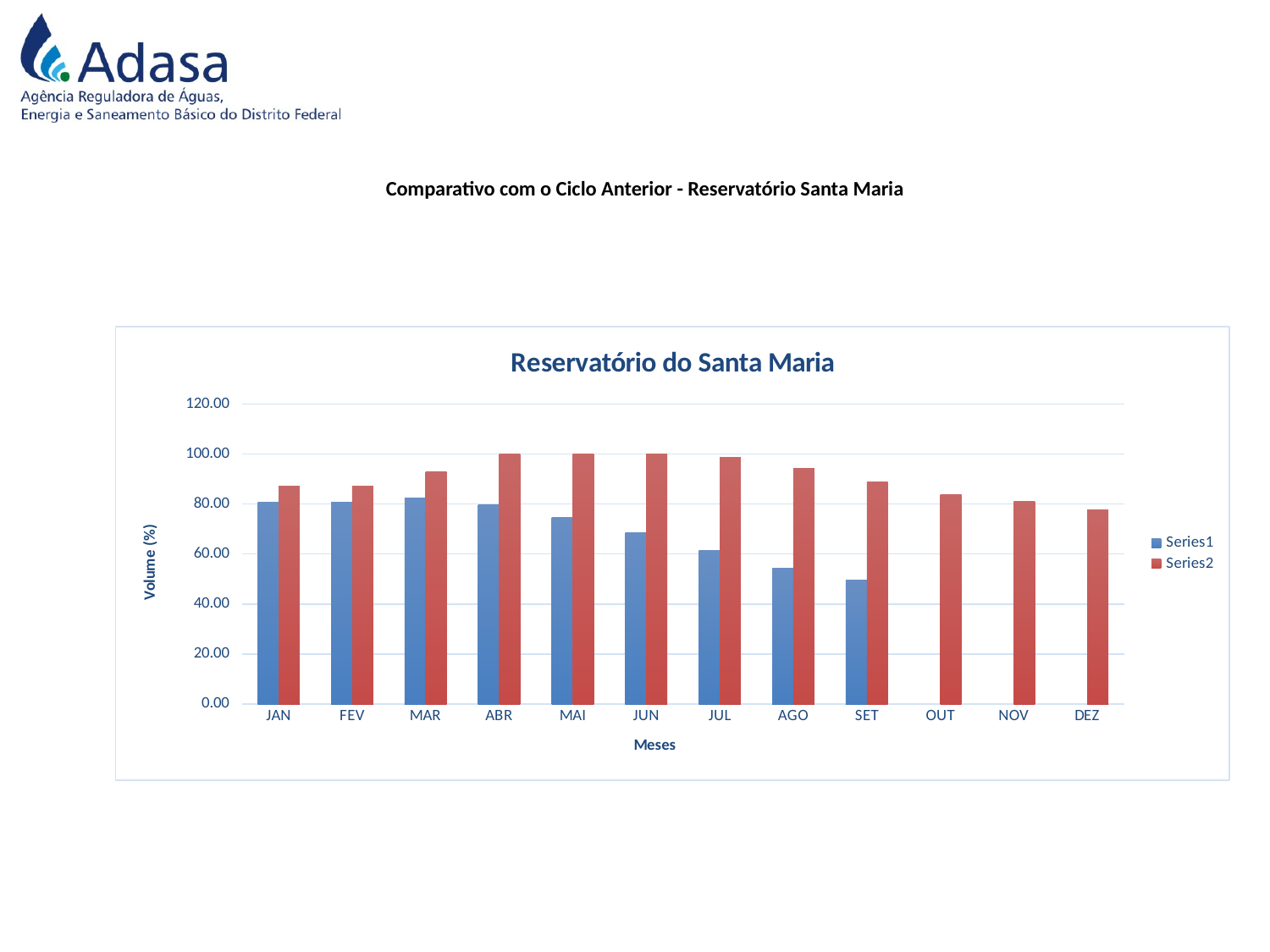
How many series does the legend list? 2 Is the Series1 value for JUL greater or less than 80.00? less Do the Series1 values rise or fall from MAR to SET? fall Is the Series2 value for MAR greater or less than 80.00? greater What is the label of the vertical axis? Volume (%) Which month has the lowest Series1 value? SET What is the title of the chart? Reservatório do Santa Maria Which month has the lowest Series2 value? DEZ Is the Series1 value for SET greater or less than 60.00? less What kind of chart is shown on the slide? bar chart How many months are shown on the x axis? 12